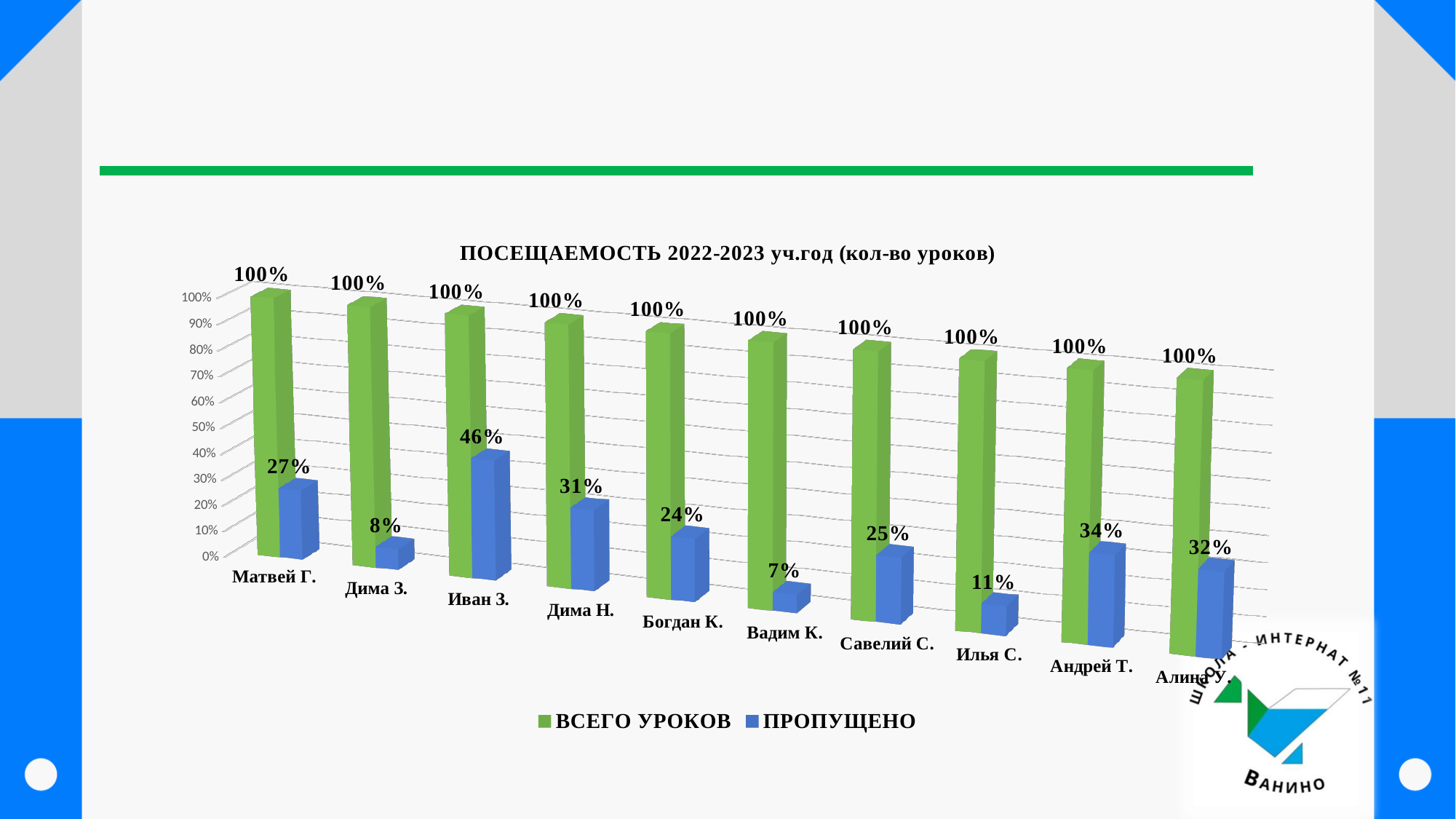
Which has a larger ПРОПУЩЕНО value, Дима Н. or Савелий С.? Дима Н. Which student has the lowest ПРОПУЩЕНО value? Вадим К. How many series does the legend list? 2 What is the difference between the ПРОПУЩЕНО values for Иван З. and Дима З.? 38% What kind of chart is shown on the slide? Bar chart What is the ПРОПУЩЕНО value for Иван З.? 46% What is the title of the chart? ПОСЕЩАЕМОСТЬ 2022-2023 уч.год (кол-во уроков) What is the ПРОПУЩЕНО value for Вадим К.? 7% Which student has the highest ПРОПУЩЕНО value? Иван З. What is the ПРОПУЩЕНО value for Андрей Т.? 34% How many students are shown on the x axis of the chart? 10 What is the ВСЕГО УРОКОВ value for Богдан К.? 100%